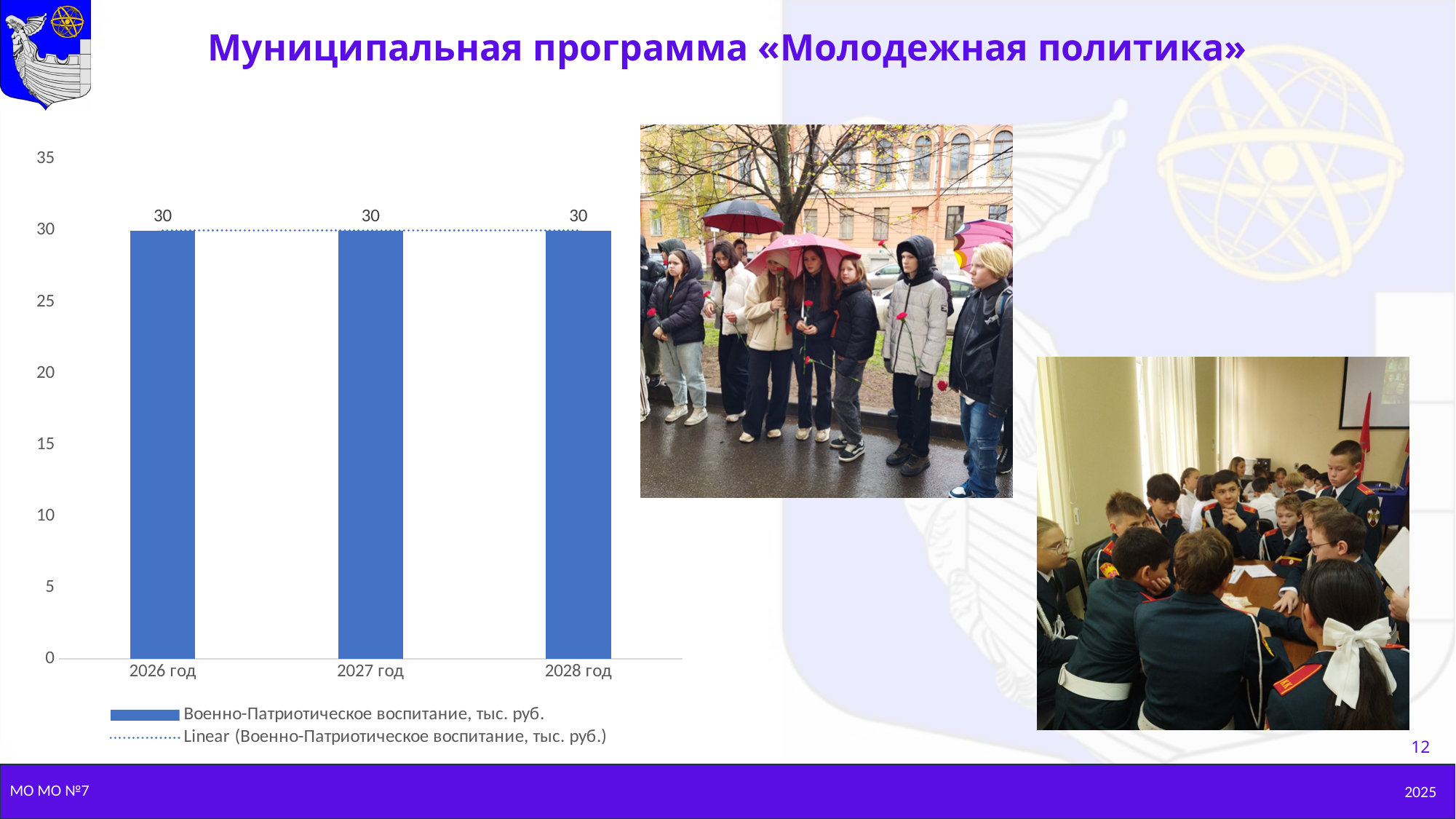
Do the values rise, fall or stay the same from 2026 год to 2028 год? stay the same What is the value for 2028 год? 30 Is the value for 2028 год greater or less than 35? less How many entries does the chart legend list? 2 Is the value for 2027 год greater or less than 25? greater What is the value for 2027 год? 30 How many categories are shown on the x axis of the chart? 3 What is the name of the data series shown by the bars in the chart? Военно-Патриотическое воспитание, тыс. руб. What is the difference between the values for 2026 год and 2028 год? 0 What kind of chart is shown on the slide? bar chart What is the value for 2026 год? 30 What colour are the bars in the chart? blue